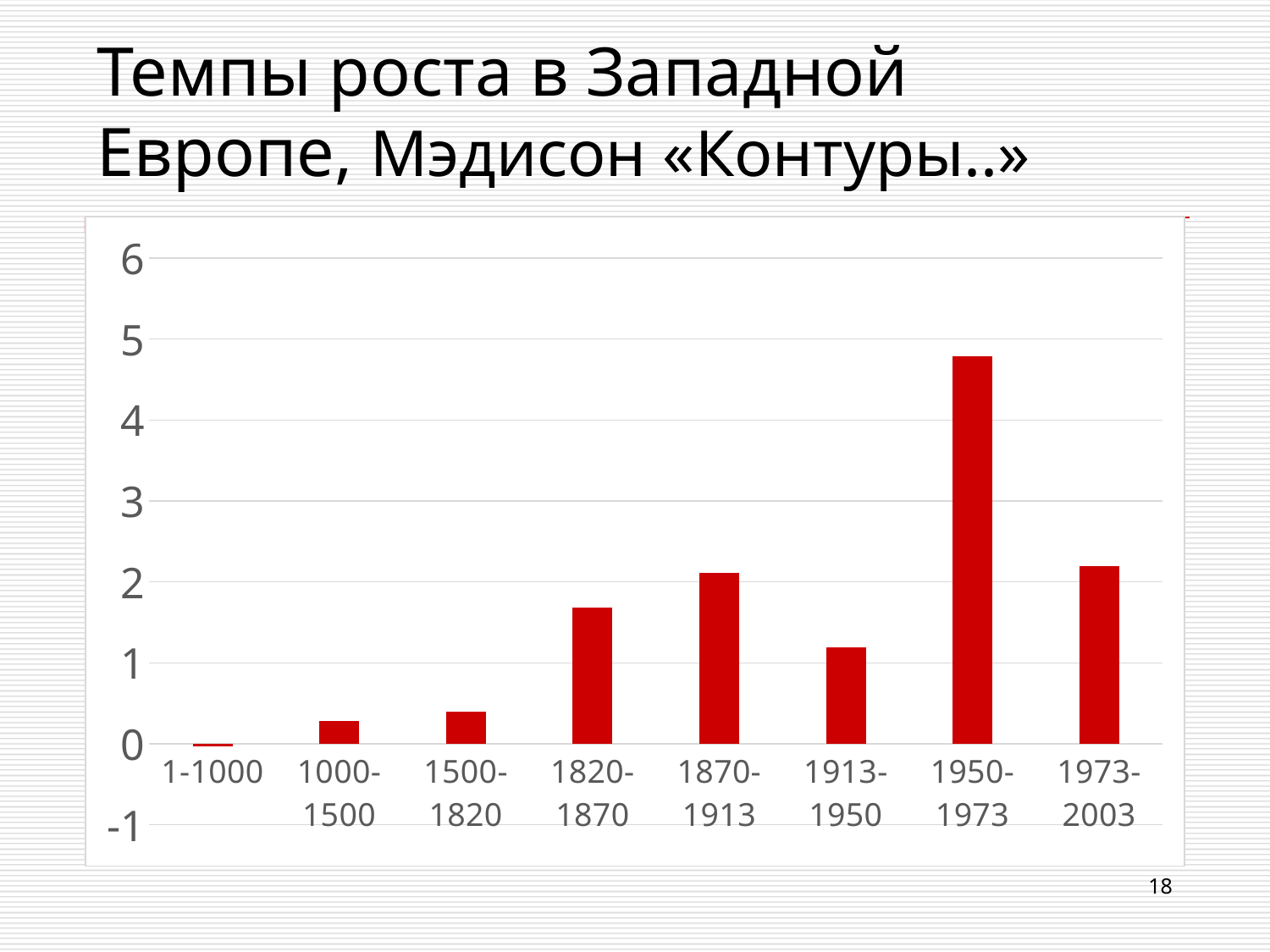
Which is larger, the value for 1950-1973 or the value for 1973-2003? 1950-1973 Is the value for 1820-1870 greater or less than 2? less What colour are the bars in the chart? red Which period has the highest growth rate? 1950-1973 Is the value for 1000-1500 greater or less than 1? less Is the value for 1913-1950 greater or less than 1? greater What kind of chart is shown on the slide? bar chart Which is larger, the value for 1820-1870 or the value for 1913-1950? 1820-1870 How many periods (categories) are shown on the x axis? 8 Which period has the lowest growth rate? 1-1000 Do the values rise or fall from 1-1000 through 1870-1913? rise